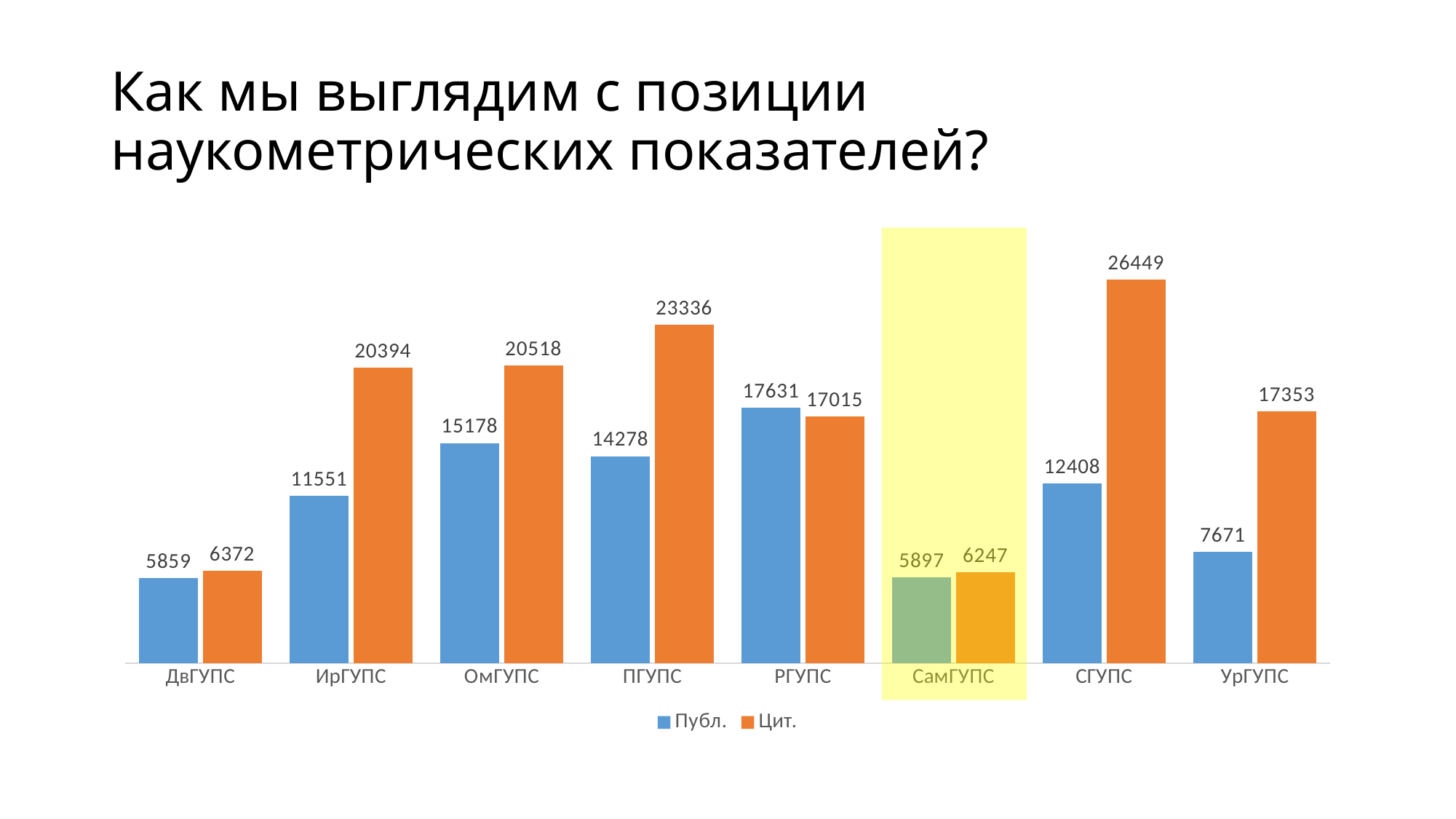
Which category has the lowest Цит. value? СамГУПС Which is larger for РГУПС, the Публ. value or the Цит. value? Публ. Which category is highlighted with a yellow background on the chart? СамГУПС What is the difference between the Цит. and Публ. values for ИрГУПС? 8843 What is the difference between the Публ. values for СГУПС and УрГУПС? 4737 What kind of chart is shown on the slide? bar chart What is the Публ. value for ПГУПС? 14278 What is the Цит. value for СамГУПС? 6247 How many categories are shown on the x axis? 8 What is the Цит. value for СГУПС? 26449 Which category has the highest Публ. value? РГУПС How many series does the legend list? 2